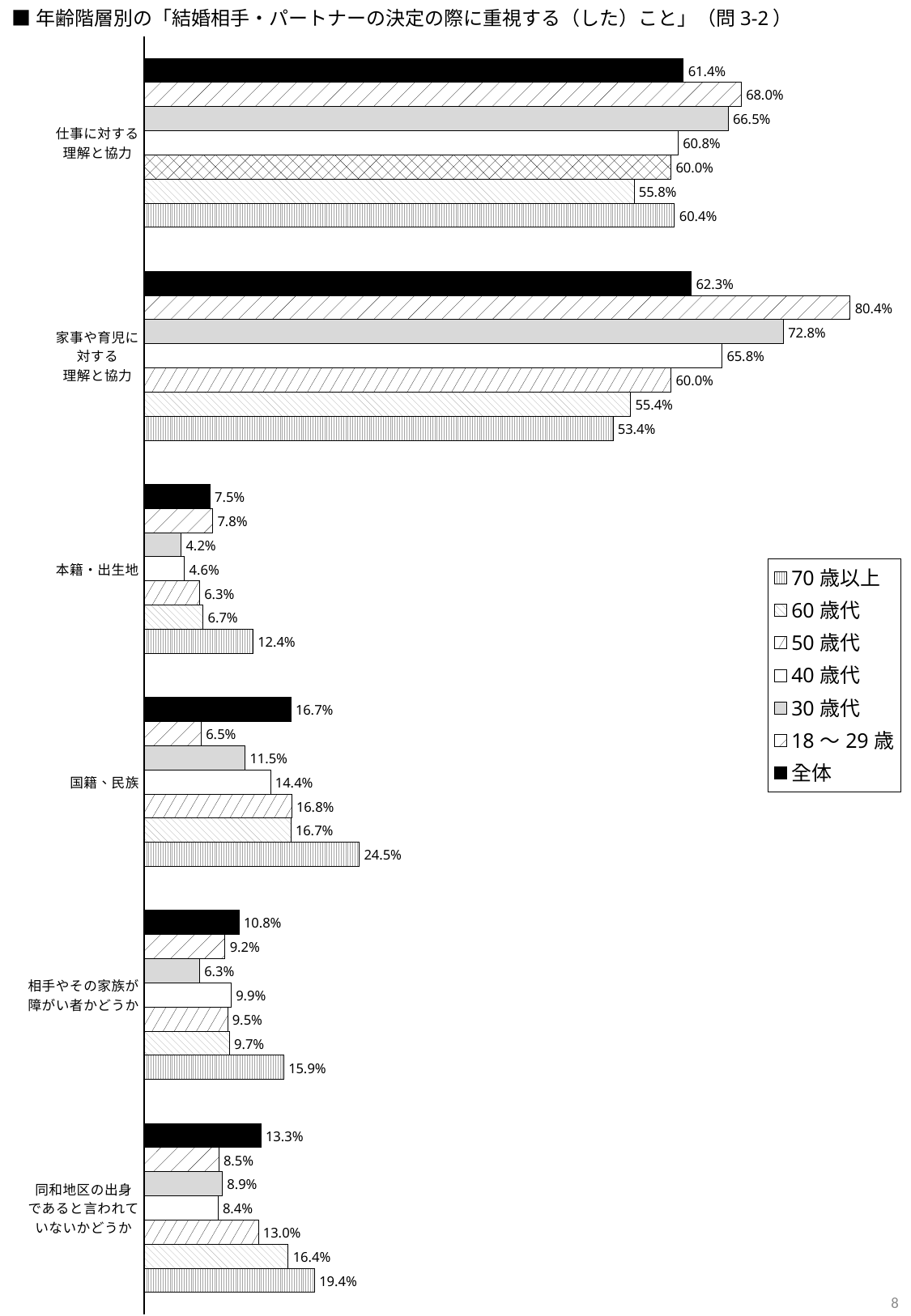
What is the value for 全体 in the category 仕事に対する理解と協力? 61.4% How many series does the legend list? 7 What is the difference between the 18～29歳 value and the 全体 value in the category 家事や育児に対する理解と協力? 18.1% Which age group has the lowest value in the category 本籍・出生地? 30歳代 In the category 同和地区の出身であると言われていないかどうか, which is larger: the value for 70歳以上 or the value for 全体? 70歳以上 What type of chart is shown on the slide? bar chart What is the value for 18～29歳 in the category 家事や育児に対する理解と協力? 80.4% How many categories are plotted on the chart? 6 What is the value for 70歳以上 in the category 相手やその家族が障がい者かどうか? 15.9% Which series is shown with solid black bars according to the legend? 全体 Which age group has the highest value in the category 家事や育児に対する理解と協力? 18～29歳 What is the value for 全体 in the category 国籍、民族? 16.7%